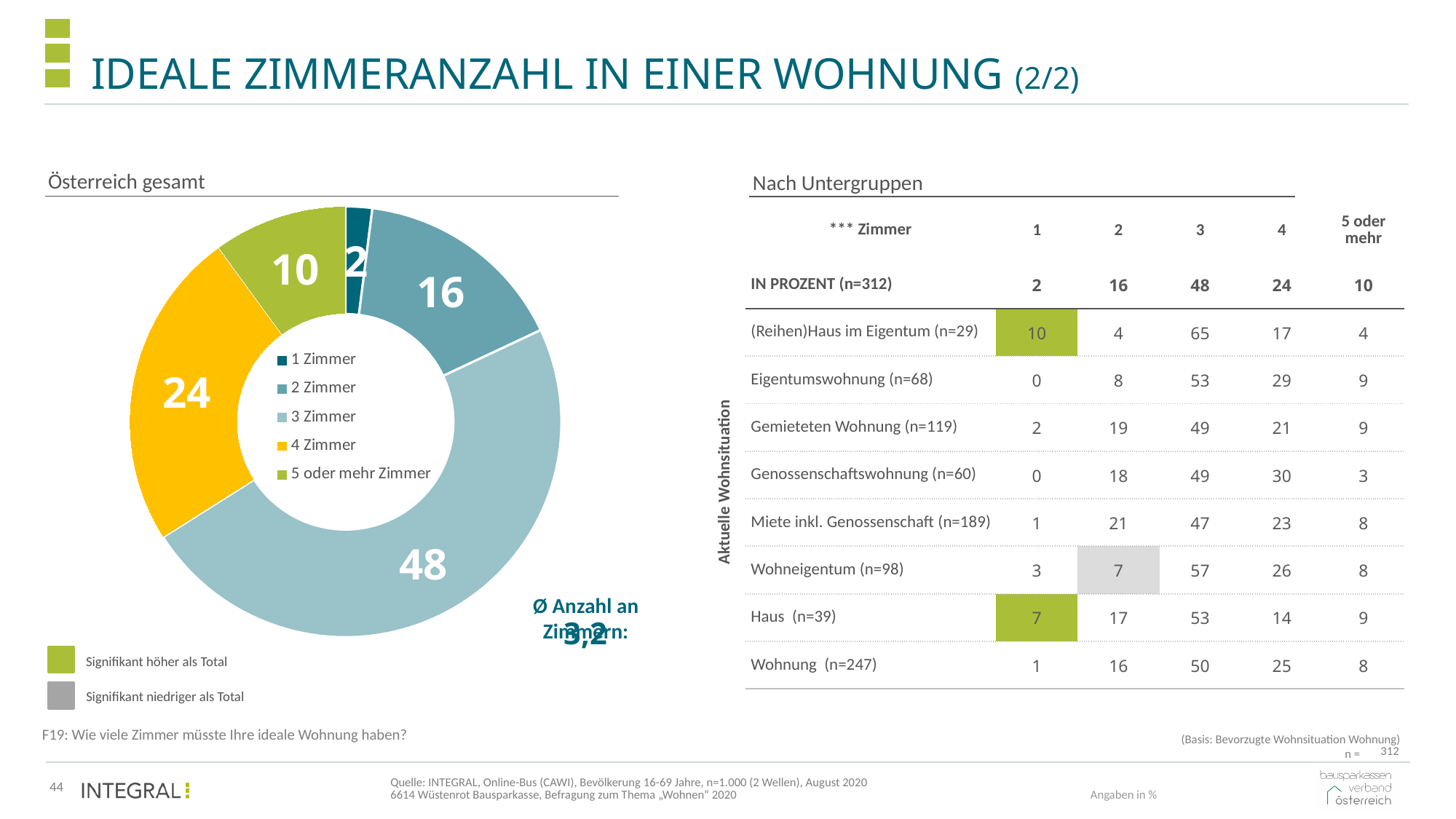
In the "Österreich gesamt" chart, what is the difference between the values for 3 Zimmer and 4 Zimmer? 24 In the "Österreich gesamt" chart, what is the value for 4 Zimmer? 24 In the "Österreich gesamt" chart, what is the value for 1 Zimmer? 2 What type of chart is shown under "Österreich gesamt"? Pie chart (donut) In the "Österreich gesamt" chart, which is larger: the value for 2 Zimmer or the value for 5 oder mehr Zimmer? 2 Zimmer In the "Österreich gesamt" chart, what share of the whole does the 4 Zimmer slice represent? 24% What colour is the 4 Zimmer slice in the "Österreich gesamt" chart? Yellow In the "Österreich gesamt" chart, what is the value for 5 oder mehr Zimmer? 10 In the "Österreich gesamt" chart, which category has the smallest slice? 1 Zimmer How many categories does the "Österreich gesamt" chart show? 5 In the "Österreich gesamt" chart, which category has the largest slice? 3 Zimmer In the "Österreich gesamt" chart, what is the value for 3 Zimmer? 48